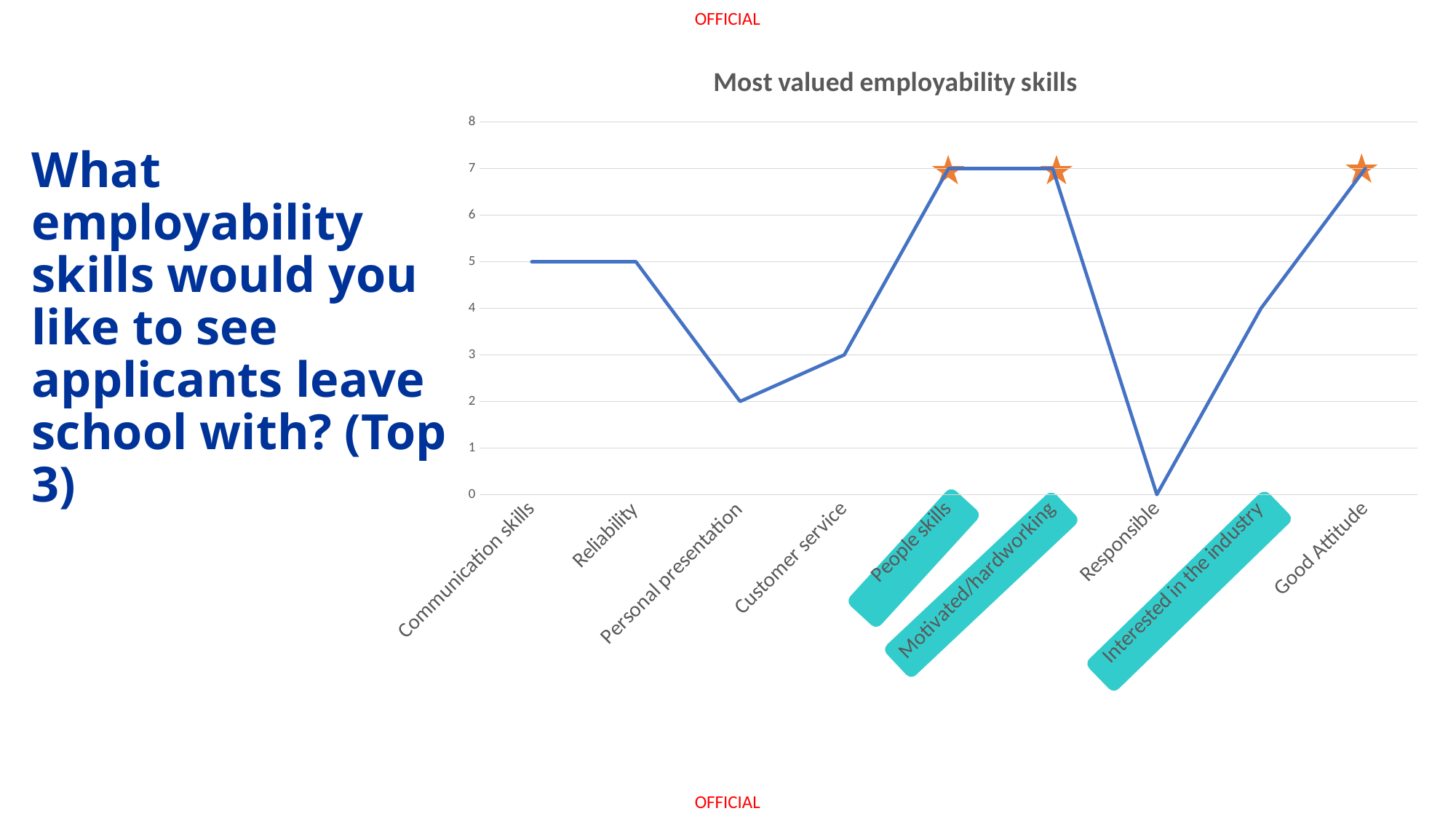
Which category has the lowest value? Responsible What is the value for Responsible? 0 Which is larger, the value for Communication skills or the value for Customer service? Communication skills What is the title of the chart? Most valued employability skills Is the value for Good Attitude greater or less than 5? greater What is the value for Personal presentation? 2 What is the value for Customer service? 3 What kind of chart is shown on the slide? Line chart How many categories are plotted along the x axis of the chart? 9 What is the value for Interested in the industry? 4 What is the difference between the value for People skills and the value for Personal presentation? 5 Do the values rise or fall from Customer service to People skills? Rise